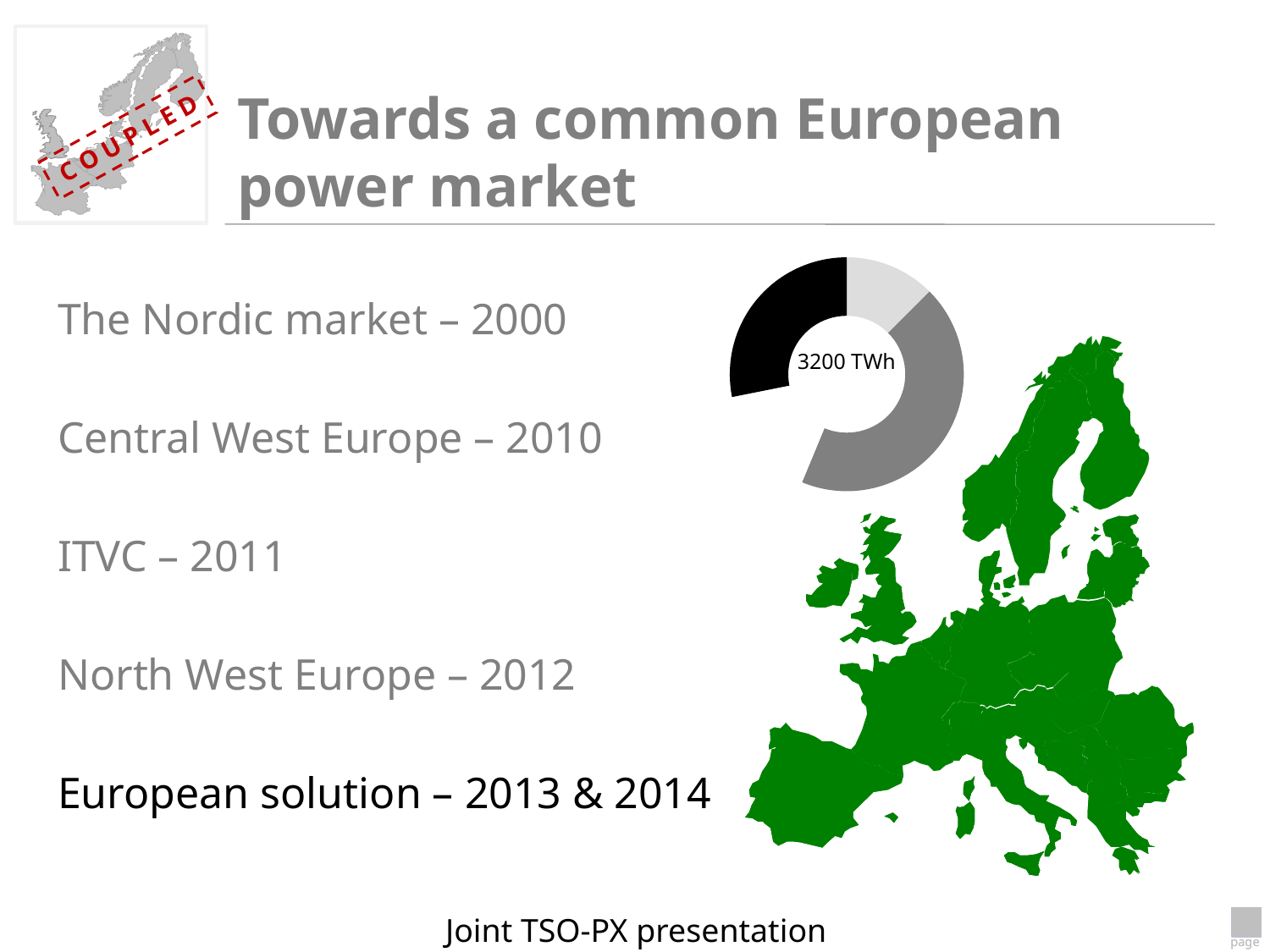
What kind of chart is shown on the right side of the slide? doughnut chart Does the doughnut chart display a legend? No In the doughnut chart, which is larger: the black slice or the light gray slice? the black slice Which colour slice of the doughnut chart is the largest? dark gray In the doughnut chart, which is larger: the dark gray slice or the black slice? the dark gray slice Which colour slice of the doughnut chart is the smallest? light gray What text is printed in the centre of the doughnut chart? 3200 TWh